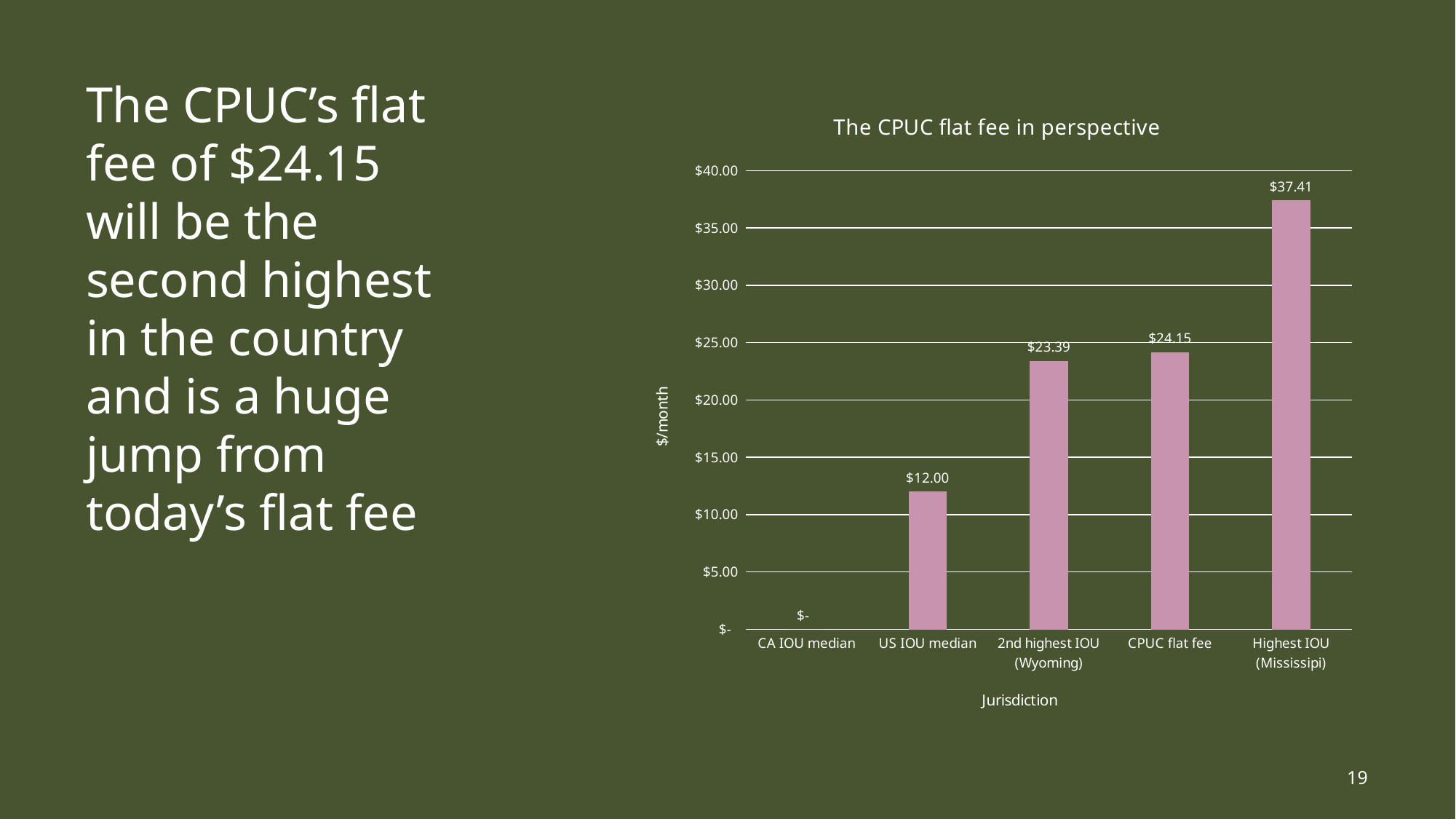
What is the value for the Highest IOU (Mississipi)? $37.41 What is the value for the US IOU median? $12.00 What is the value for the CPUC flat fee? $24.15 Which jurisdiction has the highest value in the chart? Highest IOU (Mississipi) What is the difference between the Highest IOU (Mississipi) and the CPUC flat fee? $13.26 What type of chart is shown on the slide? Bar chart Which is larger, the CPUC flat fee or the 2nd highest IOU (Wyoming)? CPUC flat fee Which jurisdiction has the lowest value in the chart? CA IOU median What is the title of the chart? The CPUC flat fee in perspective What is the label of the y axis of the chart? $/month What is the value for the 2nd highest IOU (Wyoming)? $23.39 How many jurisdictions are shown on the x axis of the chart? 5